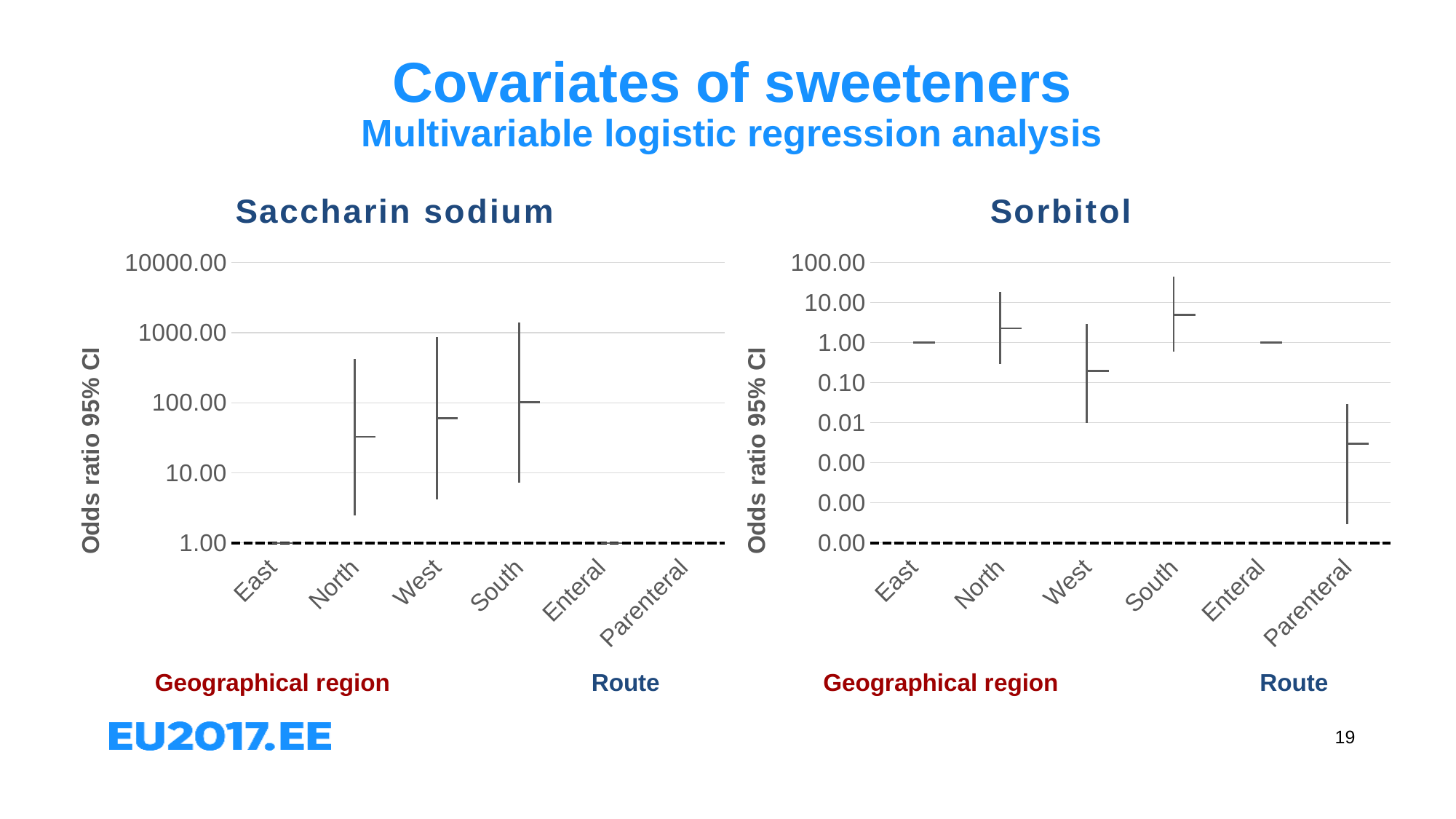
In the Sorbitol chart, which category has the lowest point estimate? Parenteral In the Sorbitol chart, which category has the highest point estimate? South How many categories are shown on the x axis of the Saccharin sodium chart? 6 What is the y-axis title of the Saccharin sodium chart? Odds ratio 95% CI In the Saccharin sodium chart, is the upper end of the confidence interval for South greater or less than 1000.00? greater In the Saccharin sodium chart, is the point estimate for West greater or less than 100.00? less In the Sorbitol chart, is the point estimate for South greater or less than 1.00? greater In the Saccharin sodium chart, which has the higher point estimate, North or West? West How many categories are shown on the x axis of the Sorbitol chart? 6